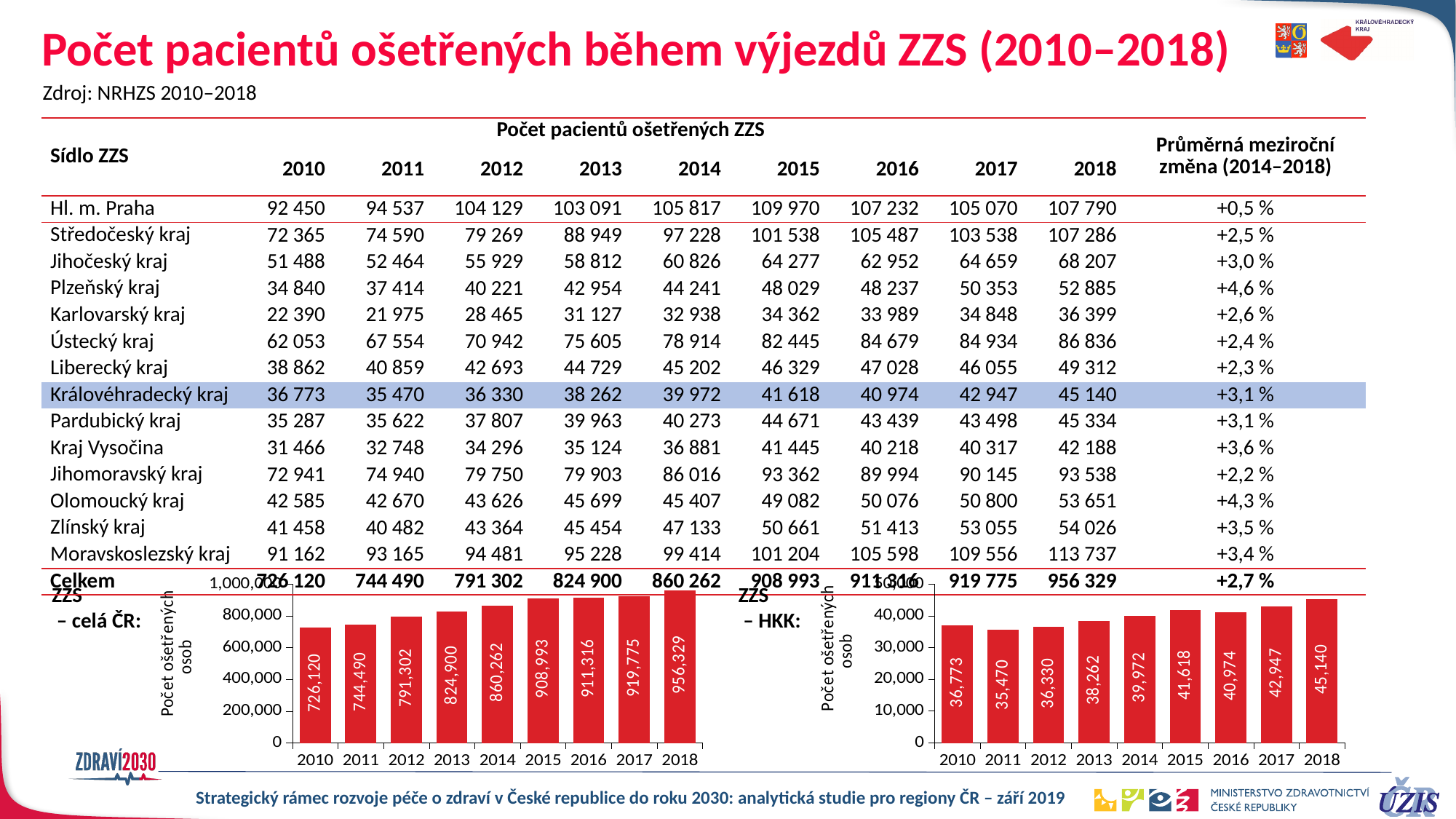
In the right chart (ZZS – HKK), what is the difference between the values for 2017 and 2016? 1,973 In the left chart (ZZS – celá ČR), what is the difference between the values for 2018 and 2010? 230,209 In the left chart (ZZS – celá ČR), what is the value for 2018? 956,329 In the left chart (ZZS – celá ČR), is the value for 2014 greater or less than 800,000? greater In the right chart (ZZS – HKK), what is the value for 2011? 35,470 In the right chart (ZZS – HKK), which year has the highest value? 2018 In the right chart (ZZS – HKK), which year has the lowest value? 2011 In the right chart (ZZS – HKK), which is larger, the value for 2015 or the value for 2016? 2015 In the left chart (ZZS – celá ČR), which year has the lowest value? 2010 In the left chart (ZZS – celá ČR), do the values generally rise or fall from 2010 to 2018? rise How many years are plotted in the left chart (ZZS – celá ČR)? 9 What kind of chart is the right chart (ZZS – HKK)? bar chart